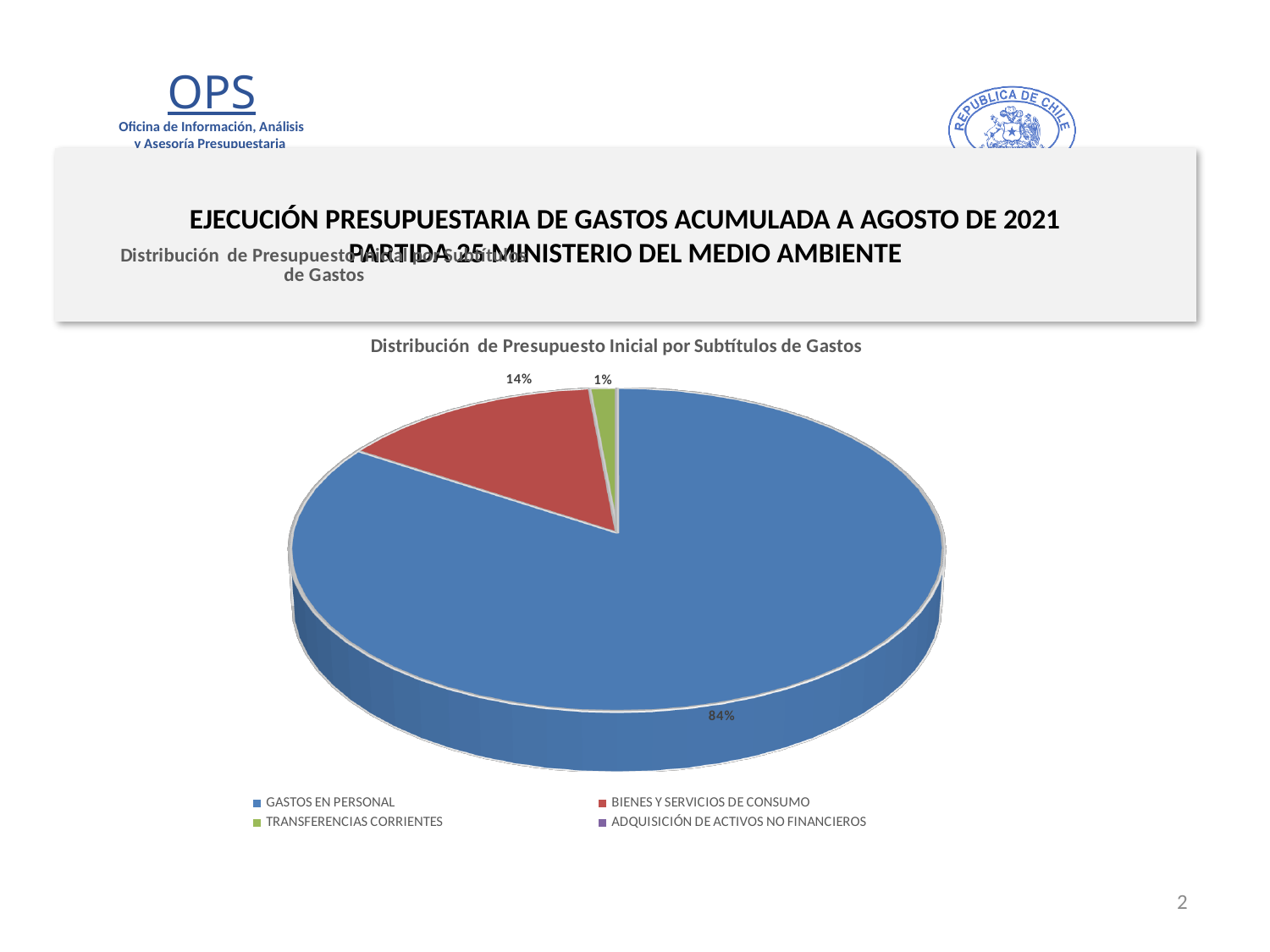
Which is larger, the BIENES Y SERVICIOS DE CONSUMO slice or the TRANSFERENCIAS CORRIENTES slice? BIENES Y SERVICIOS DE CONSUMO What kind of chart is shown on the slide? pie chart Which of the labeled slices is the smallest? TRANSFERENCIAS CORRIENTES What share of the pie does BIENES Y SERVICIOS DE CONSUMO represent? 14% Which category is shown in red in the legend? BIENES Y SERVICIOS DE CONSUMO What colour is the GASTOS EN PERSONAL slice? blue What is the difference in percentage points between the GASTOS EN PERSONAL slice and the BIENES Y SERVICIOS DE CONSUMO slice? 70 percentage points What share of the pie does GASTOS EN PERSONAL represent? 84% How many categories does the legend list? 4 What share of the pie does TRANSFERENCIAS CORRIENTES represent? 1% What is the title of the chart? Distribución de Presupuesto Inicial por Subtítulos de Gastos Which category has the largest slice of the pie? GASTOS EN PERSONAL